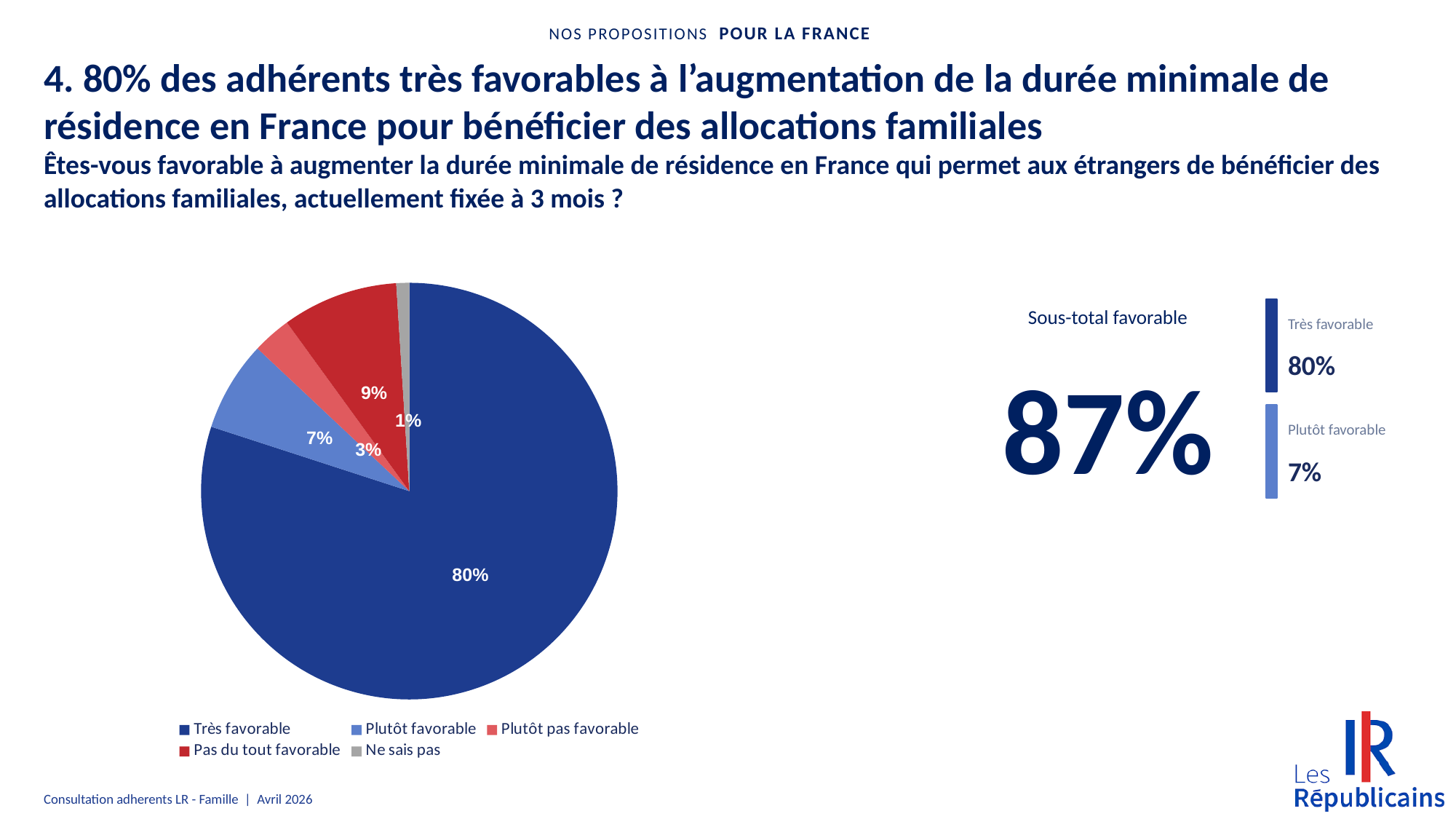
What is the "Sous-total favorable" shown next to the pie chart? 87% What kind of chart is shown on the slide? pie chart What is the difference between the "Pas du tout favorable" and "Plutôt pas favorable" shares? 6% What share of the pie is "Pas du tout favorable"? 9% How many categories does the pie chart have? 5 What share of the pie is "Plutôt pas favorable"? 3% Which is larger, the "Plutôt favorable" slice or the "Pas du tout favorable" slice? Pas du tout favorable What share of the pie is "Très favorable"? 80% Which category has the smallest slice of the pie? Ne sais pas Which category has the largest slice of the pie? Très favorable